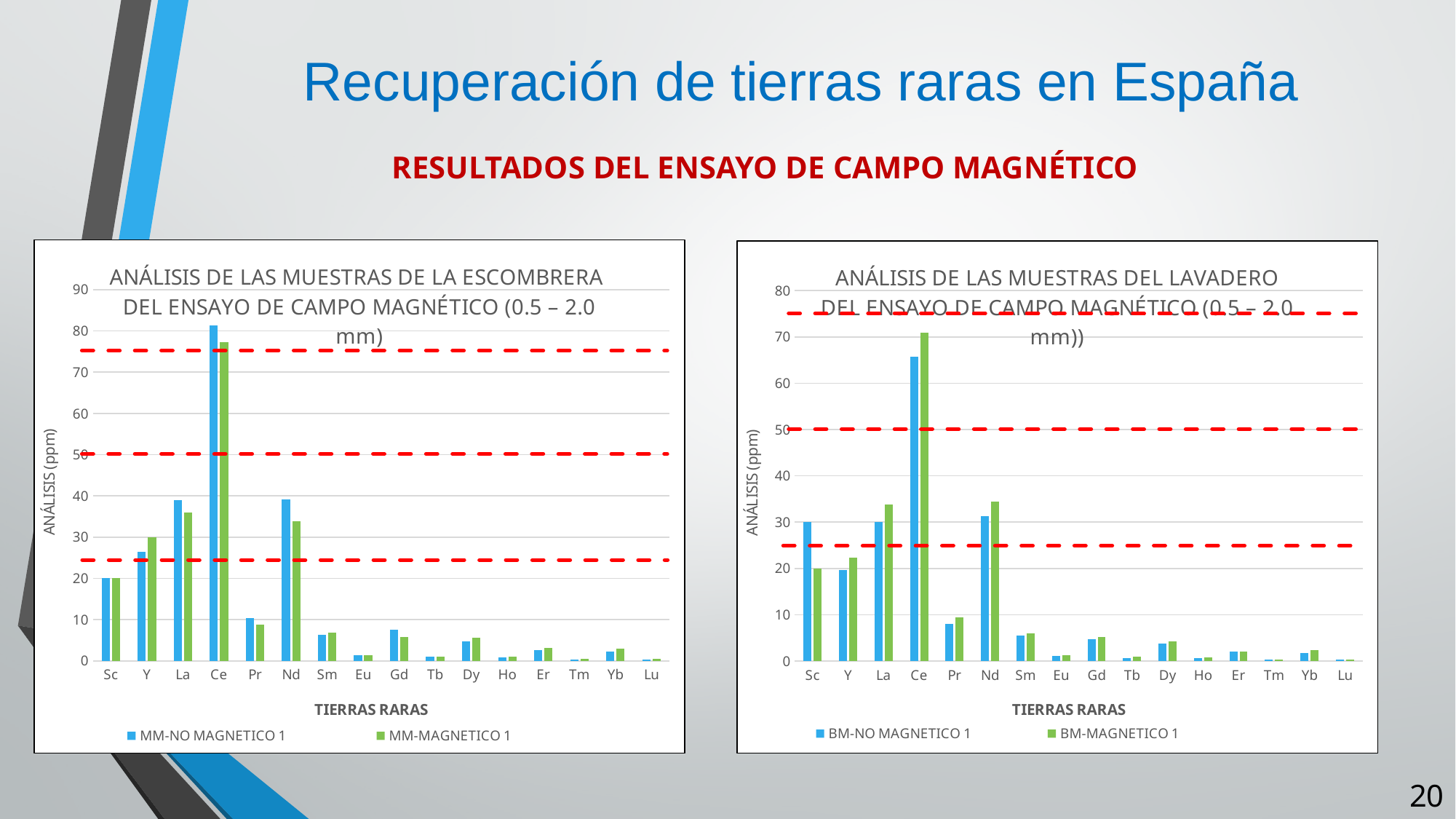
In the left chart (ESCOMBRERA), is the MM-NO MAGNETICO 1 value for Ce greater or less than 70? greater In the right chart (LAVADERO), is the BM-NO MAGNETICO 1 value for Y greater or less than 30? less What type of chart is the left chart, 'ANÁLISIS DE LAS MUESTRAS DE LA ESCOMBRERA'? Bar chart In the left chart (ESCOMBRERA), which rare earth has the highest value? Ce In the left chart (ESCOMBRERA), for Ce, which series has the larger value: MM-NO MAGNETICO 1 or MM-MAGNETICO 1? MM-NO MAGNETICO 1 In the right chart (LAVADERO), which rare earth has the highest value? Ce In the left chart (ESCOMBRERA), is the MM-NO MAGNETICO 1 value for La greater or less than 30? greater How many series does the legend of the right chart (LAVADERO) list? 2 In the left chart (ESCOMBRERA), how many rare earth categories are shown on the x axis? 16 What is the y-axis label of the right chart (LAVADERO)? ANÁLISIS (ppm) In the right chart (LAVADERO), for Ce, which series has the larger value: BM-NO MAGNETICO 1 or BM-MAGNETICO 1? BM-MAGNETICO 1